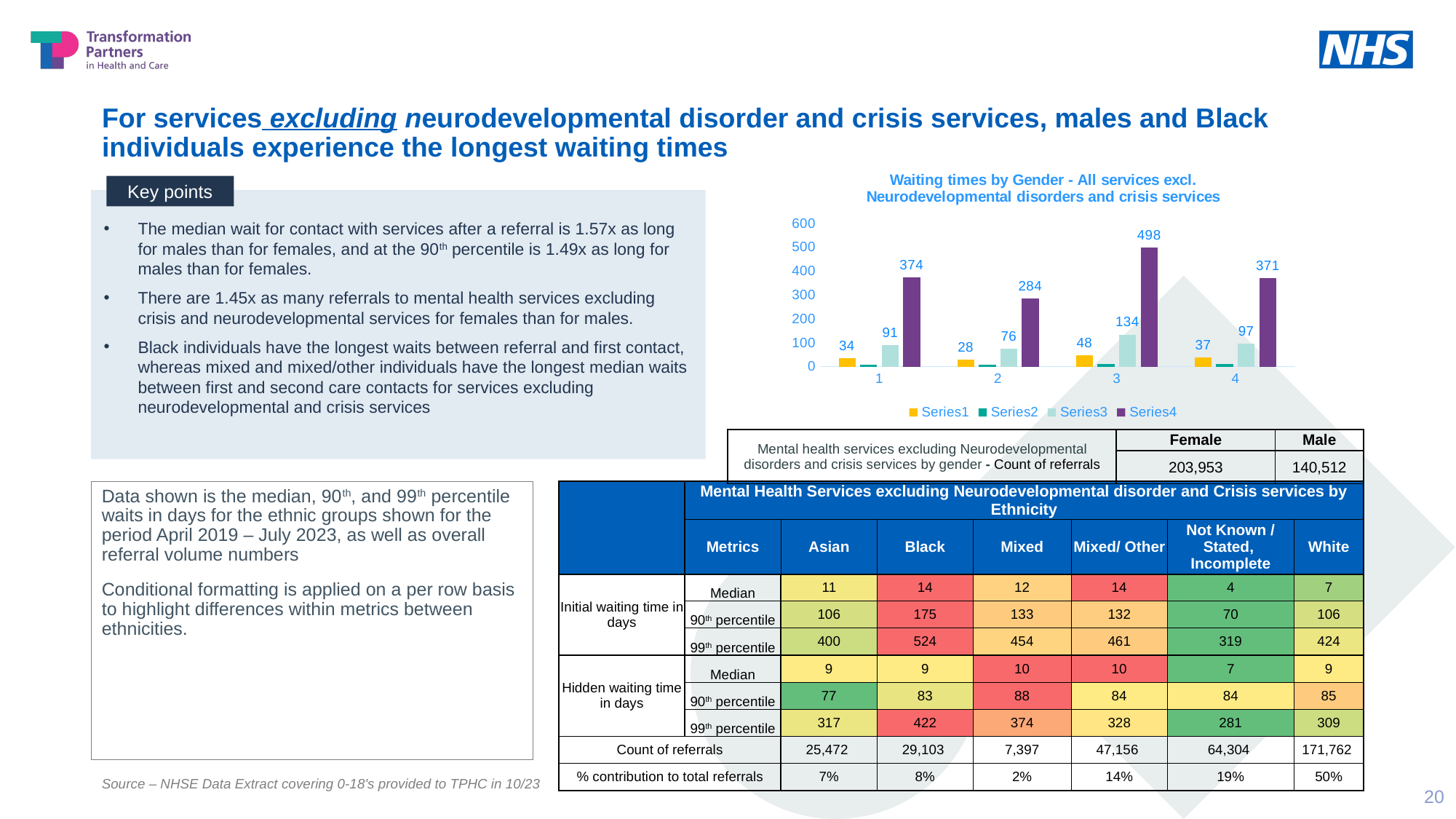
In the 'Waiting times by Gender' chart, what colour are the Series4 bars? purple In the 'Waiting times by Gender' chart, what is the value of Series3 for category 4? 97 In the 'Waiting times by Gender' chart, which is larger: Series3 for category 1 or Series3 for category 3? Series3 for category 3 In the 'Waiting times by Gender' chart, which category has the highest Series4 value? 3 In the 'Waiting times by Gender' chart, is the Series4 value for category 2 greater or less than 300? less In the 'Waiting times by Gender' chart, which category has the lowest Series3 value? 2 In the 'Waiting times by Gender' chart, what is the value of Series4 for category 3? 498 How many series does the legend of the 'Waiting times by Gender' chart list? 4 In the 'Waiting times by Gender' chart, what is the difference between the Series4 values for category 3 and category 2? 214 How many categories are shown on the x axis of the 'Waiting times by Gender' chart? 4 In the 'Waiting times by Gender' chart, what is the value of Series1 for category 2? 28 What type of chart is shown under the title 'Waiting times by Gender - All services excl. Neurodevelopmental disorders and crisis services'? bar chart